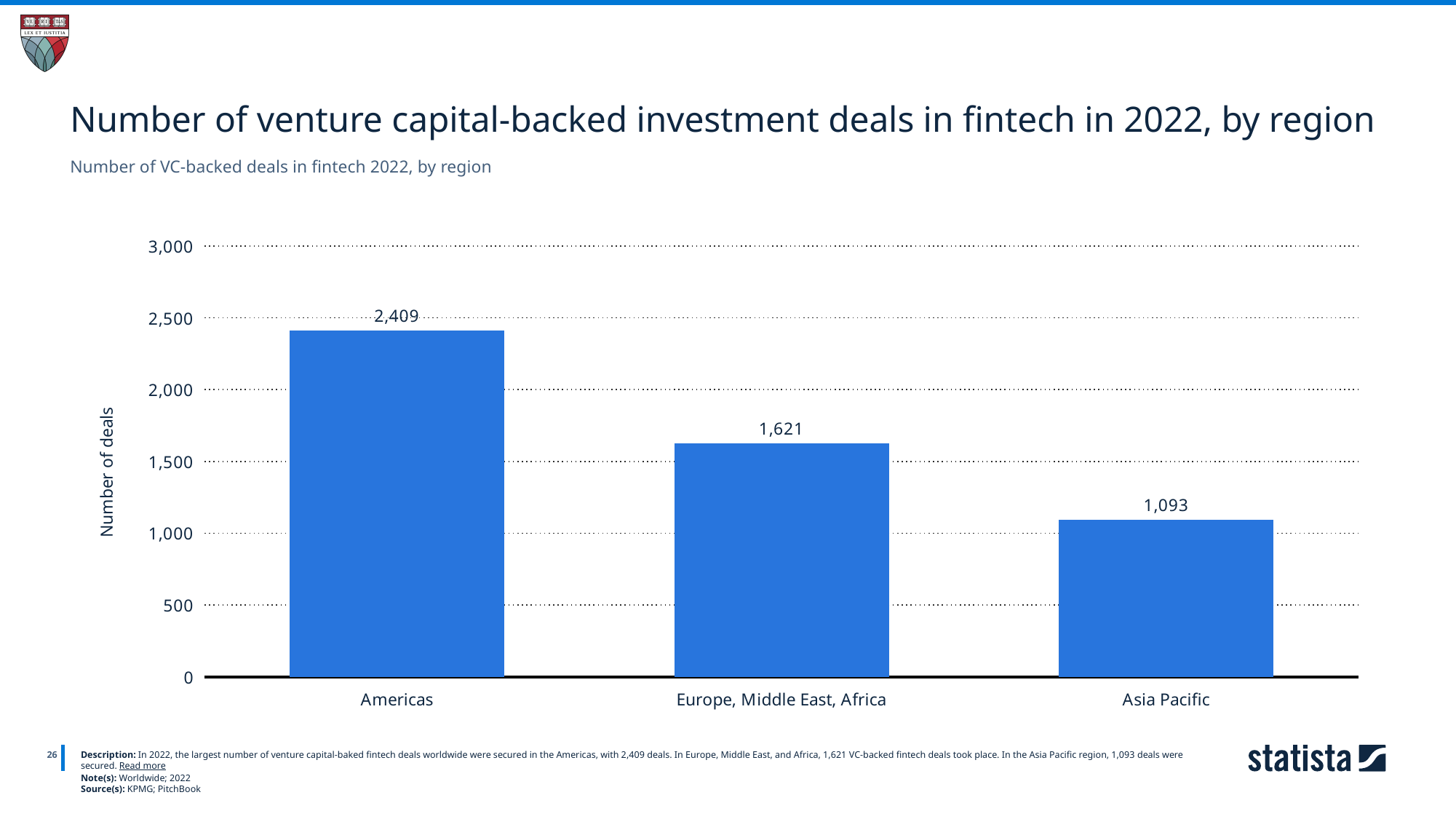
Which region has the lowest number of VC-backed fintech deals? Asia Pacific How many VC-backed fintech deals were there in the Americas in 2022? 2,409 What kind of chart is shown on the slide? Bar chart What is the difference in the number of deals between the Americas and Asia Pacific? 1,316 Is the value for Asia Pacific greater or less than 1,000? greater How many regions are shown in the chart? 3 Which has more deals: Europe, Middle East, Africa or Asia Pacific? Europe, Middle East, Africa What is the number of deals shown for Europe, Middle East, Africa? 1,621 What is the label on the vertical axis of the chart? Number of deals Which region has the highest number of VC-backed fintech deals? Americas What is the difference in the number of deals between Europe, Middle East, Africa and Asia Pacific? 528 What is the number of deals shown for Asia Pacific? 1,093